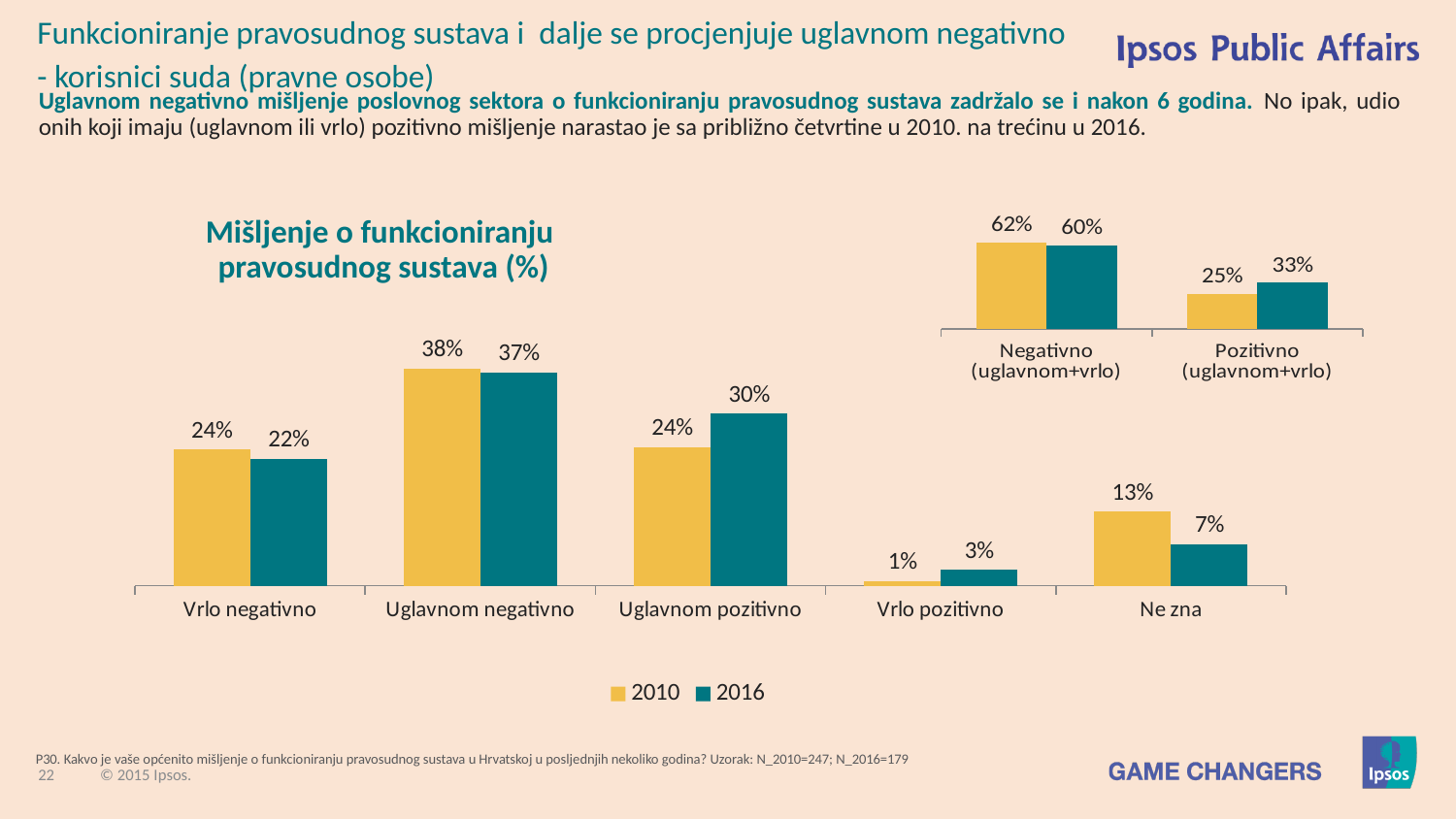
In the chart titled 'Mišljenje o funkcioniranju pravosudnog sustava (%)', which category has the highest 2010 value? Uglavnom negativno What kind of chart is the chart titled 'Mišljenje o funkcioniranju pravosudnog sustava (%)'? bar chart In the chart titled 'Mišljenje o funkcioniranju pravosudnog sustava (%)', which category has the lowest 2016 value? Vrlo pozitivno In the small chart at the top right of the slide, what is the difference between the 2010 and 2016 values for 'Pozitivno (uglavnom+vrlo)'? 8% In the chart titled 'Mišljenje o funkcioniranju pravosudnog sustava (%)', which series is shown in yellow according to the legend? 2010 How many categories are shown on the x axis of the chart titled 'Mišljenje o funkcioniranju pravosudnog sustava (%)'? 5 In the chart titled 'Mišljenje o funkcioniranju pravosudnog sustava (%)', what is the 2016 value for 'Uglavnom pozitivno'? 30% How many series does the legend of the chart titled 'Mišljenje o funkcioniranju pravosudnog sustava (%)' list? 2 In the chart titled 'Mišljenje o funkcioniranju pravosudnog sustava (%)', what is the 2010 value for 'Ne zna'? 13% In the small chart at the top right of the slide, what is the 2016 value for 'Pozitivno (uglavnom+vrlo)'? 33% In the chart titled 'Mišljenje o funkcioniranju pravosudnog sustava (%)', is the 2016 value for 'Uglavnom pozitivno' larger or smaller than the 2010 value? larger In the chart titled 'Mišljenje o funkcioniranju pravosudnog sustava (%)', what is the difference between the 2010 and 2016 values for 'Ne zna'? 6%